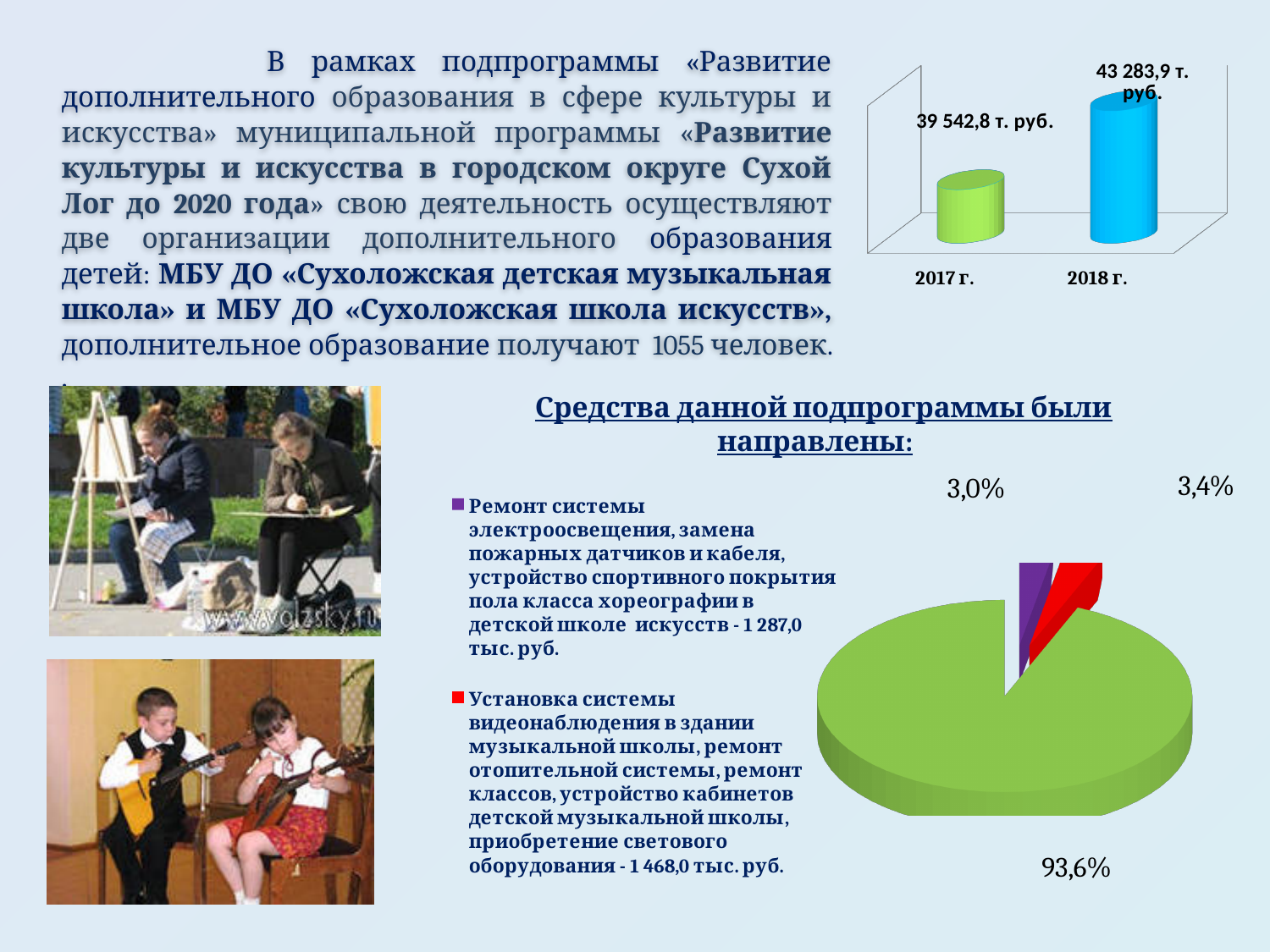
In the pie chart at the bottom right, what share does the smallest slice have? 3,0% What kind of chart is shown at the top right of the slide? Bar chart In the bar chart at the top right, which year has the higher value? 2018 г. In the pie chart at the bottom right, how many slices are there? 3 In the pie chart at the bottom right, what share does the largest slice have? 93,6% What kind of chart is shown at the bottom right of the slide? Pie chart In the bar chart at the top right, by how much does the 2018 г. value exceed the 2017 г. value? 3 741,1 т. руб. In the bar chart at the top right, which year has the lower value? 2017 г. In the bar chart at the top right, what is the value for 2017 г.? 39 542,8 т. руб. In the bar chart at the top right, what is the value for 2018 г.? 43 283,9 т. руб. In the bar chart at the top right, do the values rise or fall from 2017 г. to 2018 г.? Rise In the bar chart at the top right, how many categories are shown on the x axis? 2